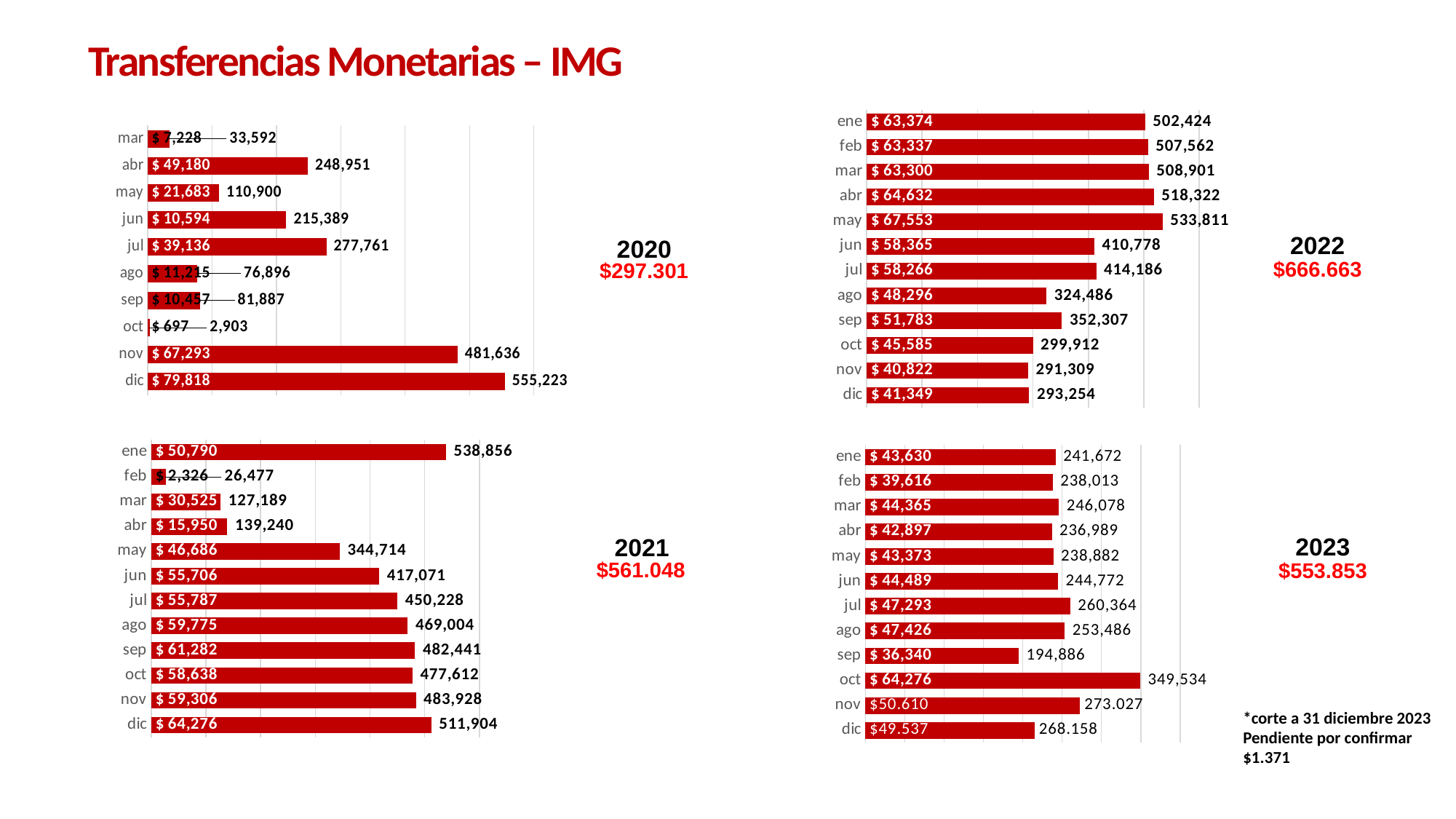
In the 2021 chart, what is the difference between the end-of-bar values for dic (511,904) and nov (483,928)? 27,976 In the 2022 chart, which month has the highest value? may In the 2022 chart, which is larger, the value for ene or the value for feb? feb What type of chart is used for the 2021 data? Bar chart In the 2022 chart, which month has the lowest value? nov In the 2023 chart, which month has the highest value? oct In the 2020 chart, what is the dollar amount shown inside the bar for dic? $ 79,818 How many months are plotted in the 2020 chart? 10 In the 2020 chart, which month has the longest bar? dic In the 2020 chart, which month has the shortest bar? oct In the 2023 chart, which month has the lowest value? sep In the 2021 chart, what is the value printed at the end of the bar for ene? 538,856